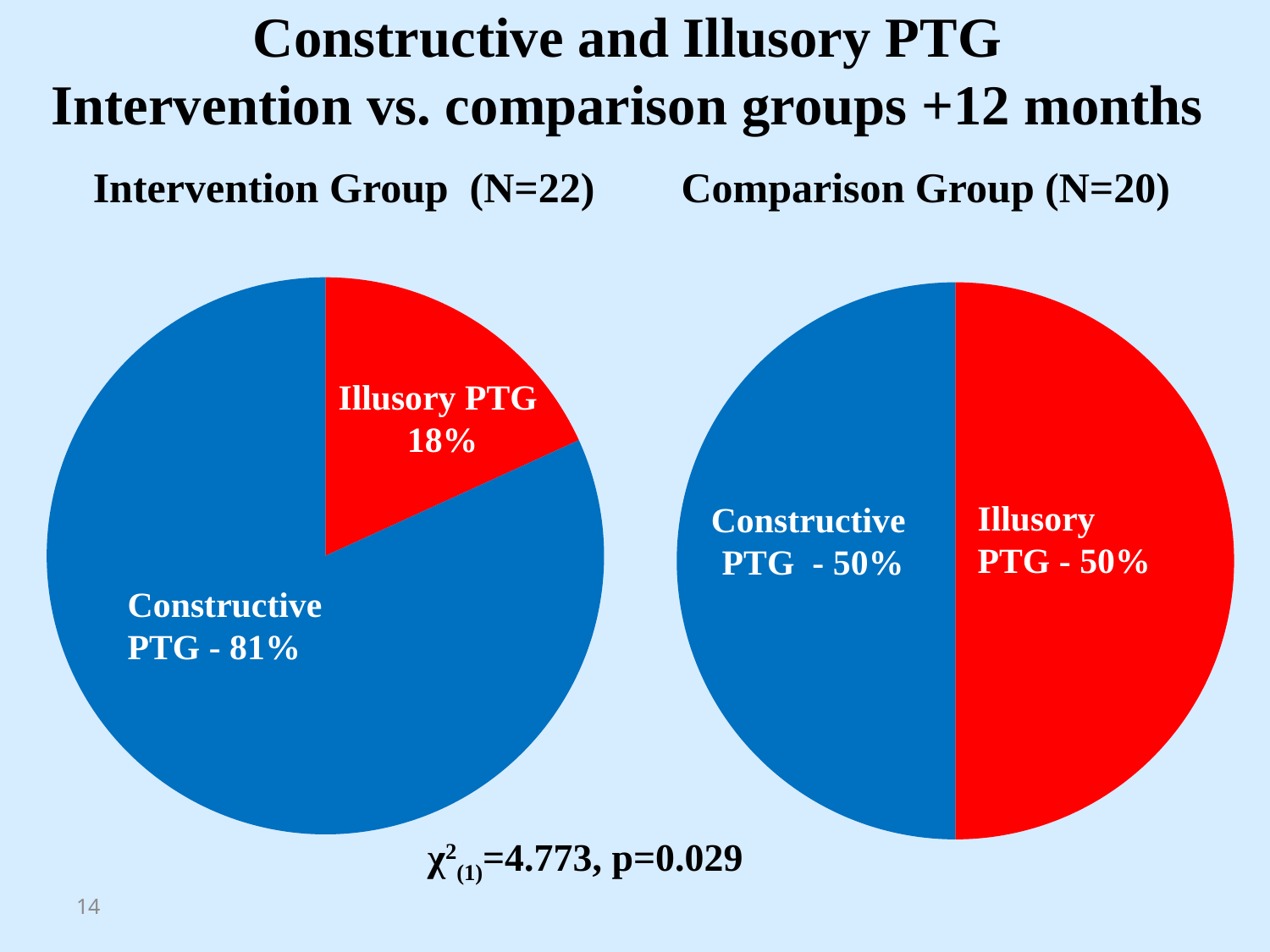
Which is larger: the Illusory PTG share in the Intervention Group (N=22) chart or the Illusory PTG share in the Comparison Group (N=20) chart? Comparison Group (N=20) How many pie charts are shown on the slide? 2 In the Intervention Group (N=22) pie chart, what share is labelled for Constructive PTG? 81% In the Intervention Group (N=22) pie chart, which slice is the smallest? Illusory PTG What colour is the Illusory PTG slice in the Comparison Group (N=20) pie chart? Red In the Comparison Group (N=20) pie chart, what share is labelled for Illusory PTG? 50% What kind of chart is used for the Intervention Group (N=22)? Pie chart In the Intervention Group (N=22) pie chart, what is the difference between the Constructive PTG and Illusory PTG shares? 63% How many slices does the Comparison Group (N=20) pie chart have? 2 In the Comparison Group (N=20) pie chart, what share is labelled for Constructive PTG? 50% In the Intervention Group (N=22) pie chart, what share is labelled for Illusory PTG? 18% In the Intervention Group (N=22) pie chart, which slice is the largest? Constructive PTG